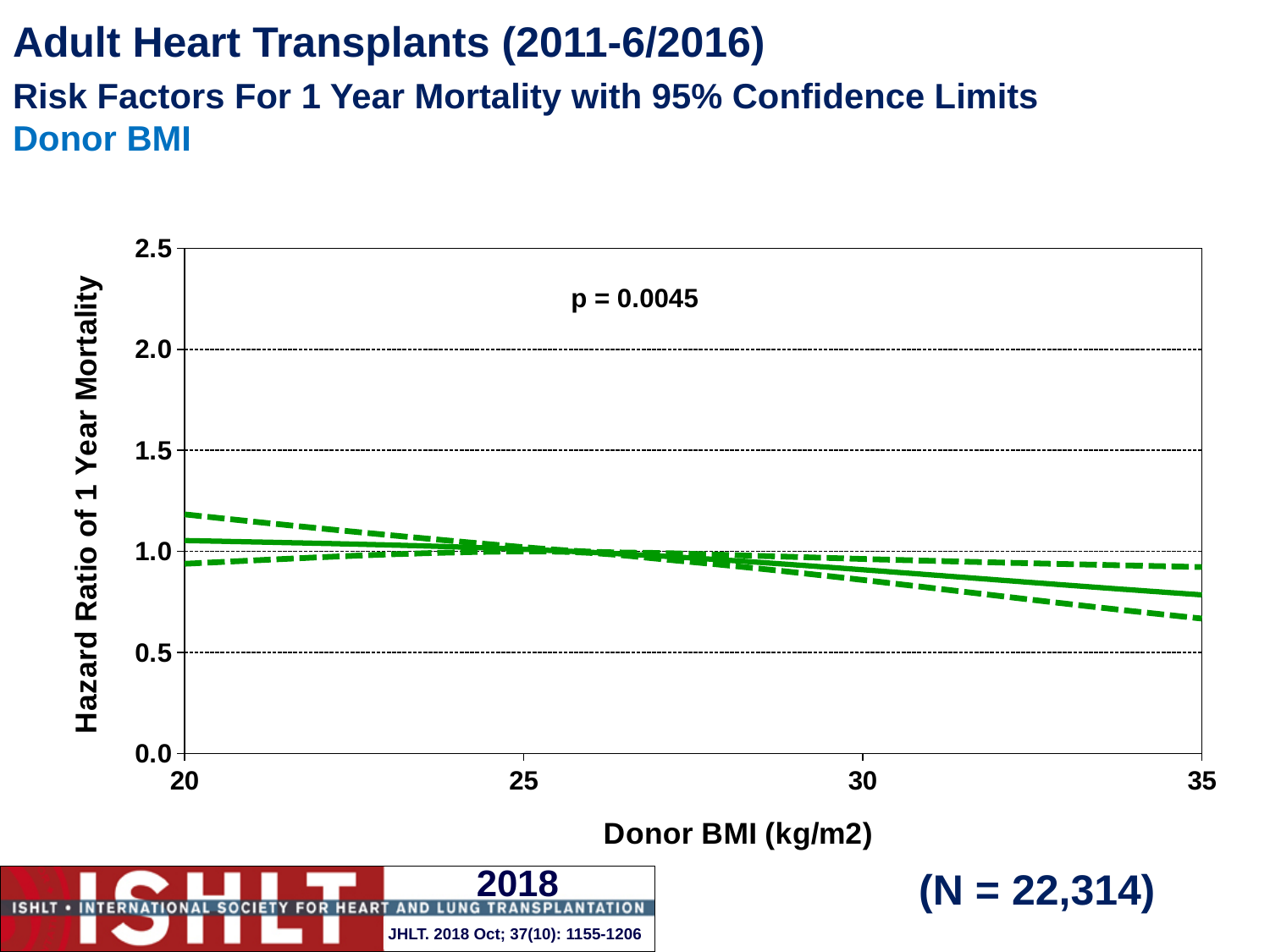
What kind of chart is shown on the slide? line chart Does the solid hazard ratio line rise or fall as donor BMI increases from 20 to 35? fall How many lines are plotted on the chart? 3 Is the lower 95% confidence limit (lower dashed line) at a donor BMI of 35 greater or less than 0.5? greater What p-value is shown on the chart? p = 0.0045 Is the upper 95% confidence limit (upper dashed line) at a donor BMI of 20 greater or less than 1.0? greater Is the hazard ratio (solid line) at a donor BMI of 35 greater or less than 1.0? less Is the hazard ratio (solid line) higher at a donor BMI of 20 or at a donor BMI of 35? 20 What is the sample size (N) shown on the slide? N = 22,314